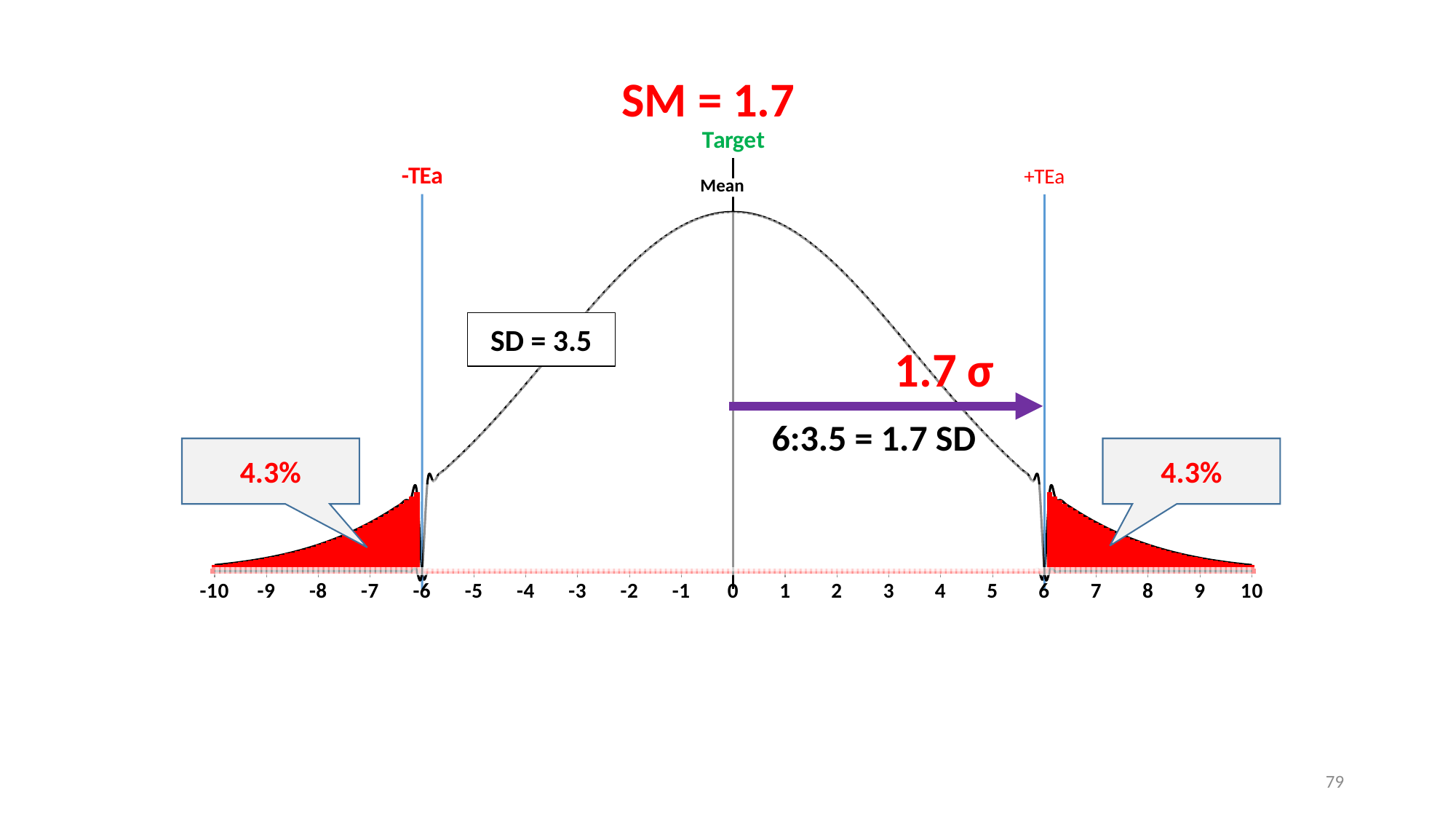
What percentage is shown in the callout for the left shaded tail? 4.3% At which x-axis value is the +TEa line located? 6 What is the value of SM shown above the chart? 1.7 What colour are the shaded tail areas beyond the TEa lines? Red What is the combined percentage of the two shaded tails? 8.6% How many tick labels are shown on the x axis? 21 Does the curve rise or fall as x increases from 0 to 6? Fall At which x-axis value is the -TEa line located? -6 At which x-axis value is the Mean line located? 0 What kind of chart is shown on the slide? Line chart (normal distribution curve) What is the value of SD shown on the chart? 3.5 What percentage is shown in the callout for the right shaded tail? 4.3%